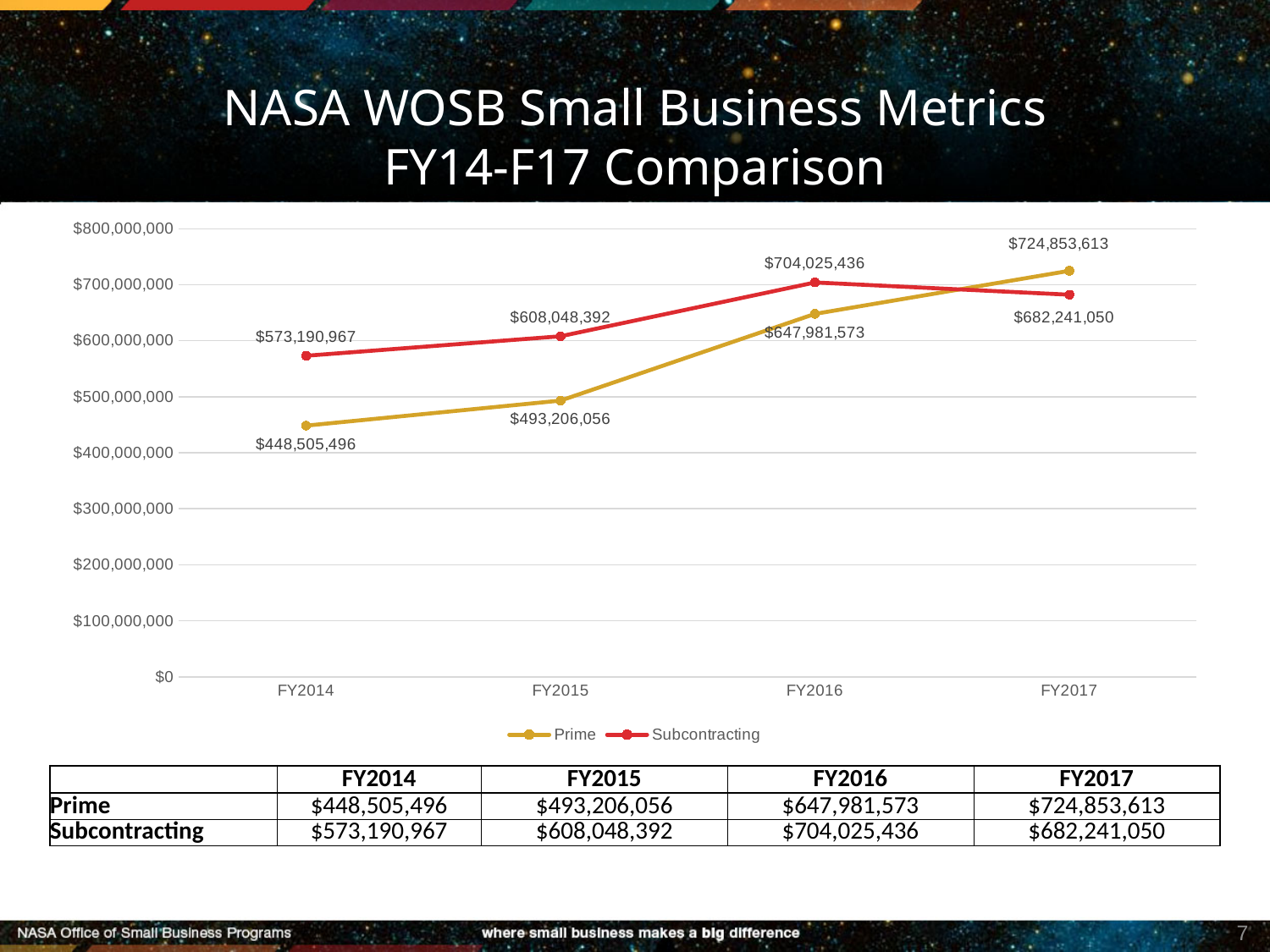
By how much did the Prime value increase from FY2014 to FY2017? $276,348,117 Does the Prime series rise or fall from FY2014 to FY2017? Rise What is the difference between the Subcontracting and Prime values in FY2014? $124,685,471 How many series does the legend list? 2 In which fiscal year is the Prime value lowest? FY2014 What is the Prime value for FY2014? $448,505,496 What is the Prime value for FY2017? $724,853,613 Which is larger in FY2017, Prime or Subcontracting? Prime In which fiscal year is the Subcontracting value highest? FY2016 How many fiscal years are plotted on the x axis? 4 What type of chart is shown on the slide? Line chart What is the Subcontracting value for FY2016? $704,025,436